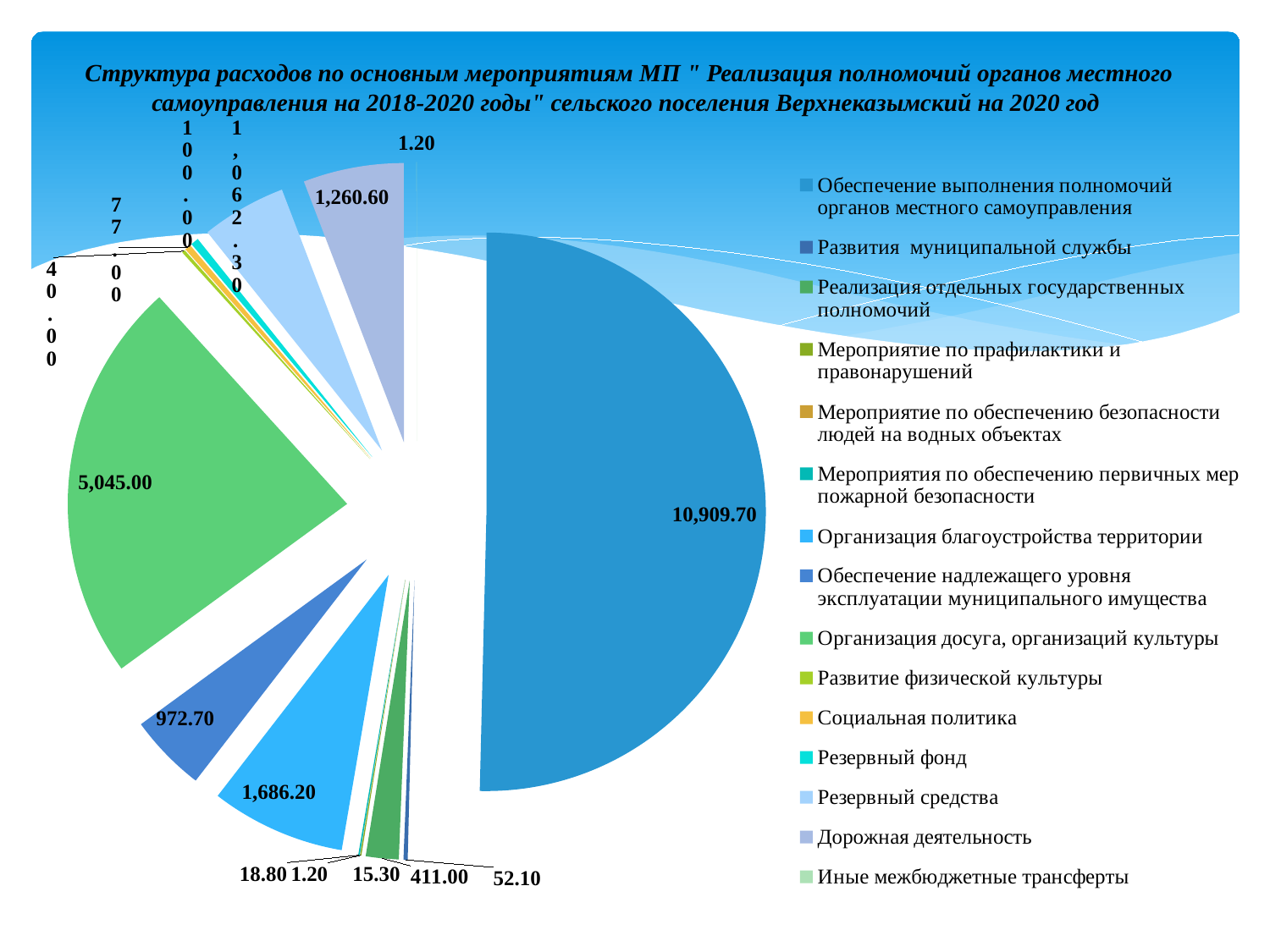
Which year does the chart title say the expenditure structure is for? 2020 What is the difference between the value for "Организация благоустройства территории" and the value for "Обеспечение надлежащего уровня эксплуатации муниципального имущества"? 713.50 How many categories does the legend list? 15 What is the difference between the value for "Обеспечение выполнения полномочий органов местного самоуправления" and the value for "Организация досуга, организаций культуры"? 5,864.70 What kind of chart is shown on the slide? pie chart Which category has the largest slice of the pie? Обеспечение выполнения полномочий органов местного самоуправления What is the value for "Обеспечение надлежащего уровня эксплуатации муниципального имущества"? 972.70 What is the value for "Организация досуга, организаций культуры"? 5,045.00 What is the value shown for the largest slice of the pie? 10,909.70 What is the value for "Организация благоустройства территории"? 1,686.20 Which is larger: the value for "Организация благоустройства территории" or the value for "Обеспечение надлежащего уровня эксплуатации муниципального имущества"? Организация благоустройства территории What is the value for "Дорожная деятельность"? 1,260.60